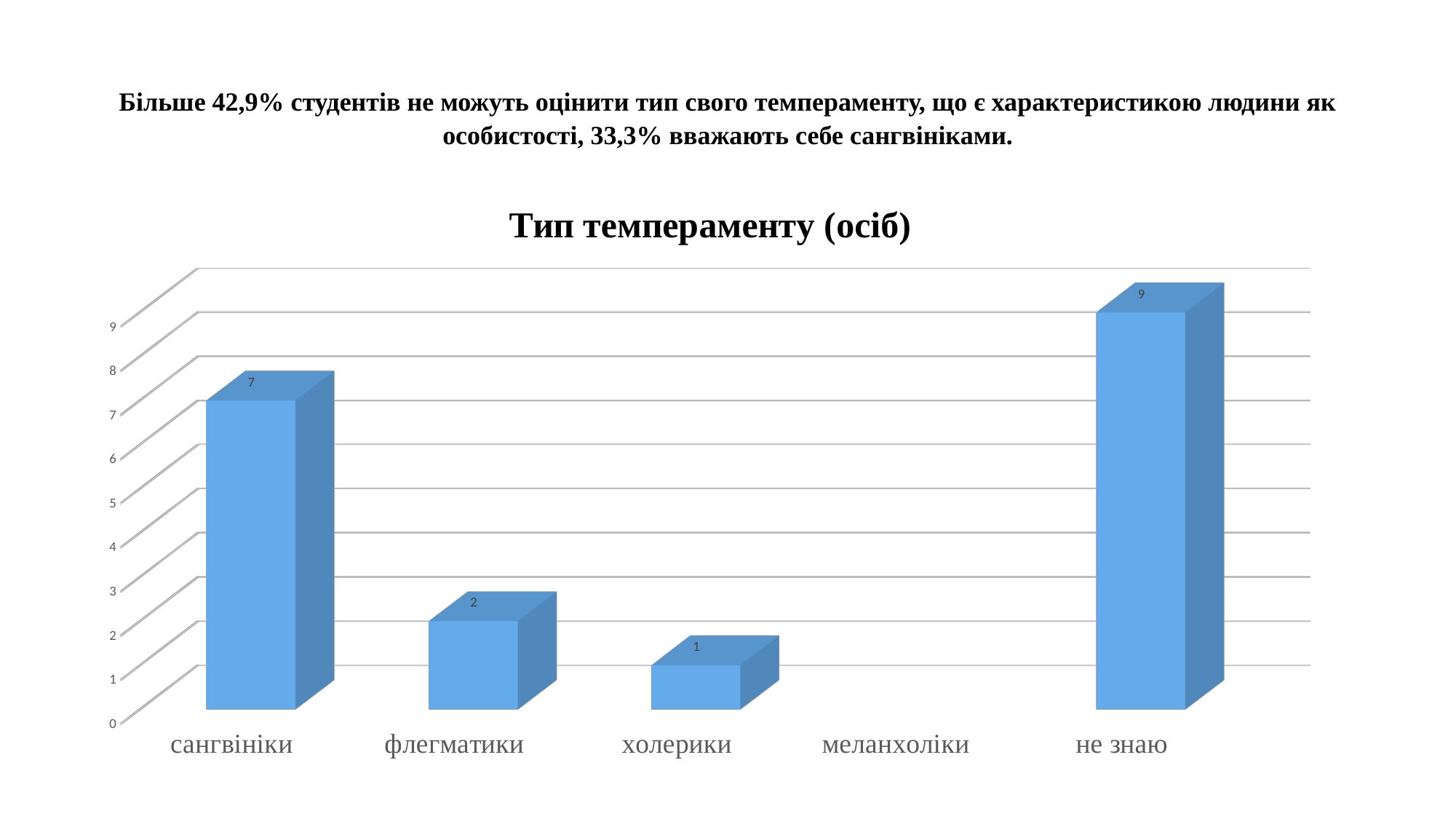
What is the difference between the values for сангвініки and флегматики? 5 Which category has no bar shown on the chart? меланхоліки What is the title of the chart? Тип темпераменту (осіб) Which category has the highest value? не знаю How many categories are shown on the x axis? 5 Which is larger, the value for флегматики or the value for холерики? флегматики What is the value for холерики? 1 What is the value for сангвініки? 7 What type of chart is shown on the slide? bar chart What is the difference between the values for не знаю and сангвініки? 2 What is the value for не знаю? 9 What is the value for флегматики? 2